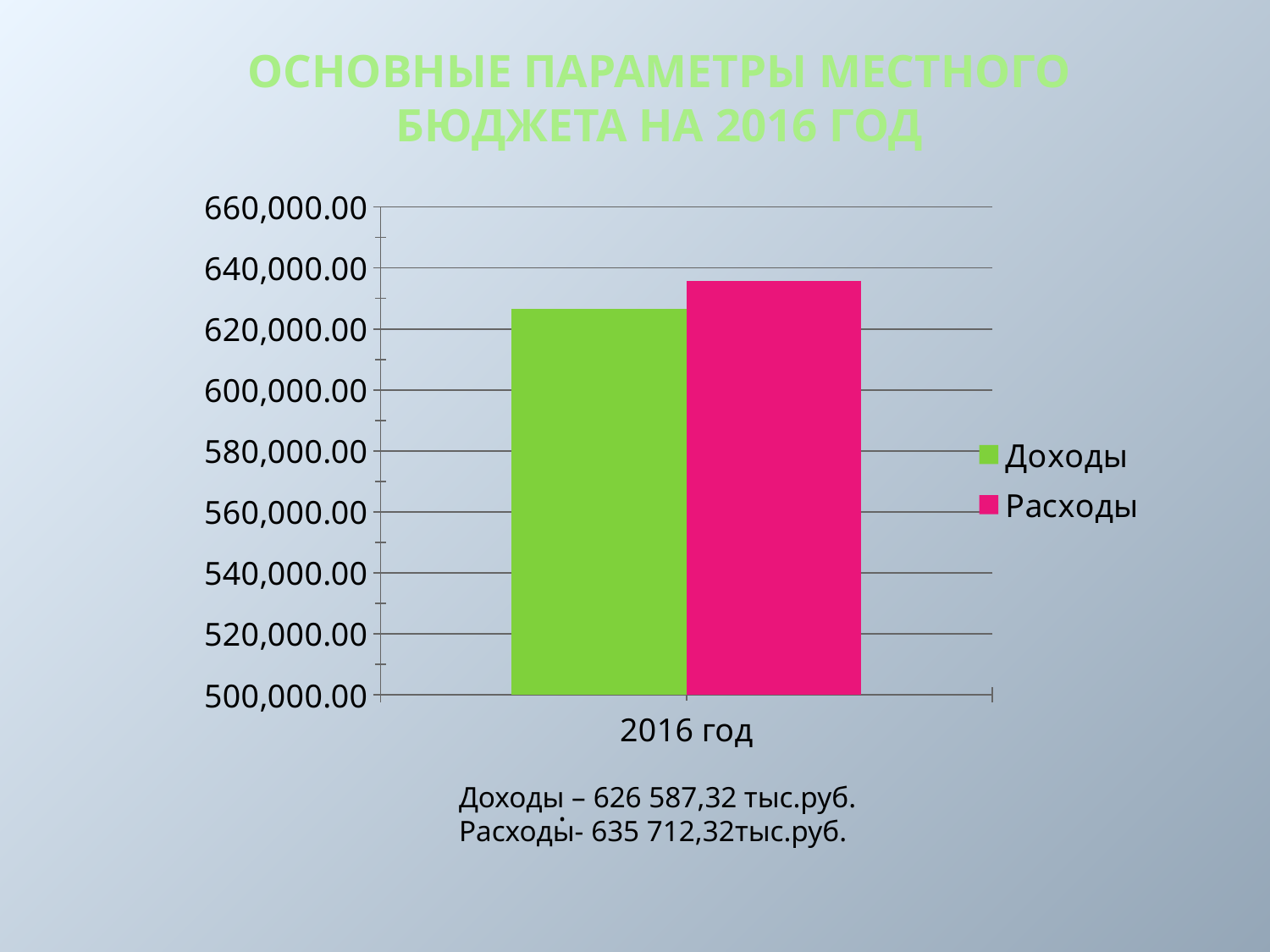
What is the value of Доходы for 2016 год? 626 587,32 тыс.руб. Which series has the lowest bar? Доходы What type of chart is shown on the slide? bar chart How many categories are shown on the x axis? 1 Which is larger for 2016 год, Доходы or Расходы? Расходы How many series does the legend list? 2 What is the difference between Расходы and Доходы for 2016 год? 9 125,00 тыс.руб. Is the value for Расходы greater or less than 640,000.00? less Which series has the highest bar? Расходы What colour is the Доходы series in the chart? green What is the value of Расходы for 2016 год? 635 712,32 тыс.руб. Is the value for Доходы greater or less than 620,000.00? greater